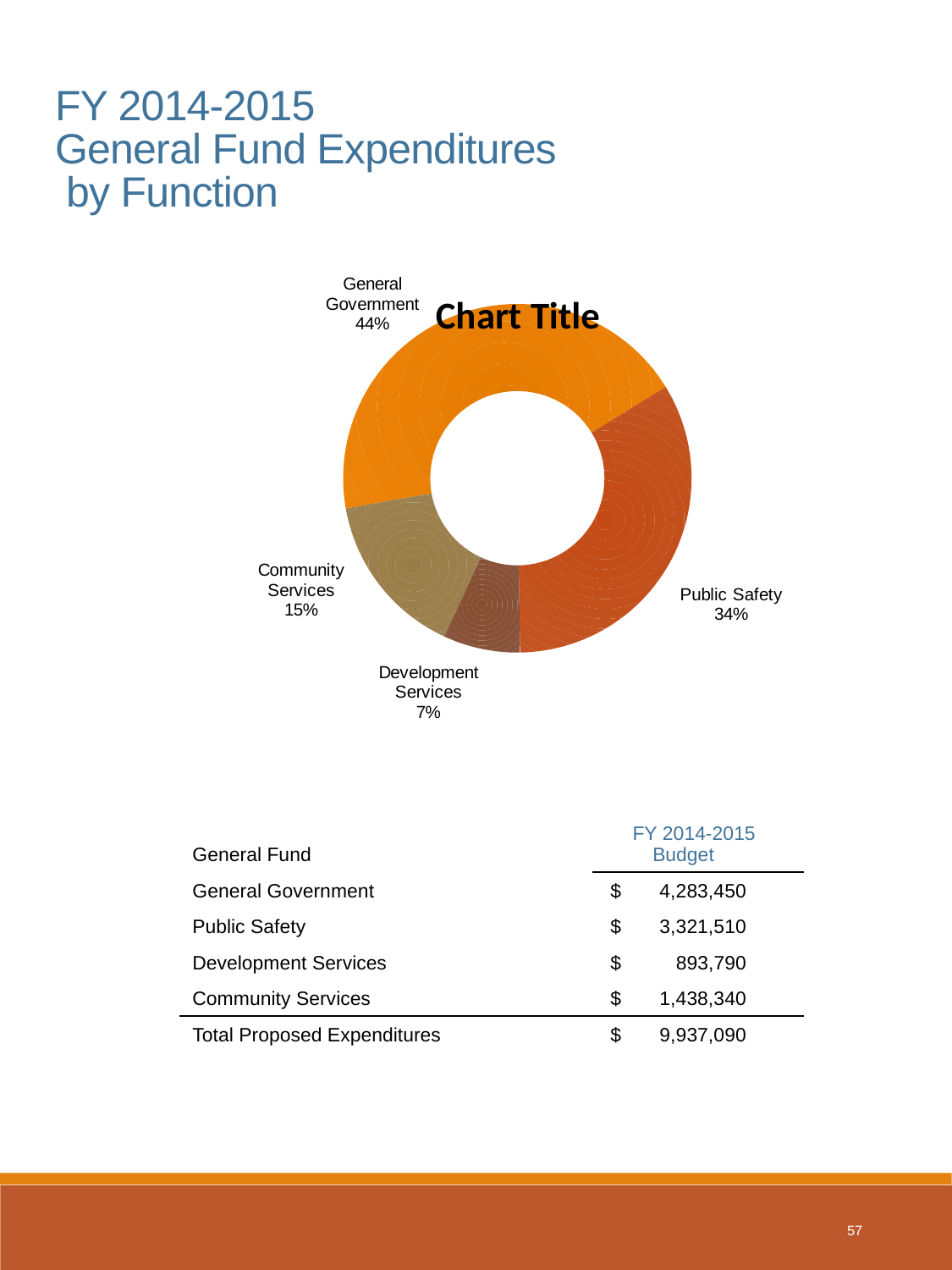
What kind of chart is shown on the slide? Doughnut (pie) chart What share of the doughnut chart does Community Services represent? 15% What share of the doughnut chart does Development Services represent? 7% What is the difference in percentage points between the General Government and Public Safety slices? 10 Which slice is larger, Community Services or Development Services? Community Services How many categories are shown in the chart? 4 What share of the doughnut chart does Public Safety represent? 34% Which category has the smallest slice in the chart? Development Services What is the title printed on the chart? Chart Title What is the difference in percentage points between the Public Safety and Community Services slices? 19 Which category has the largest slice in the chart? General Government